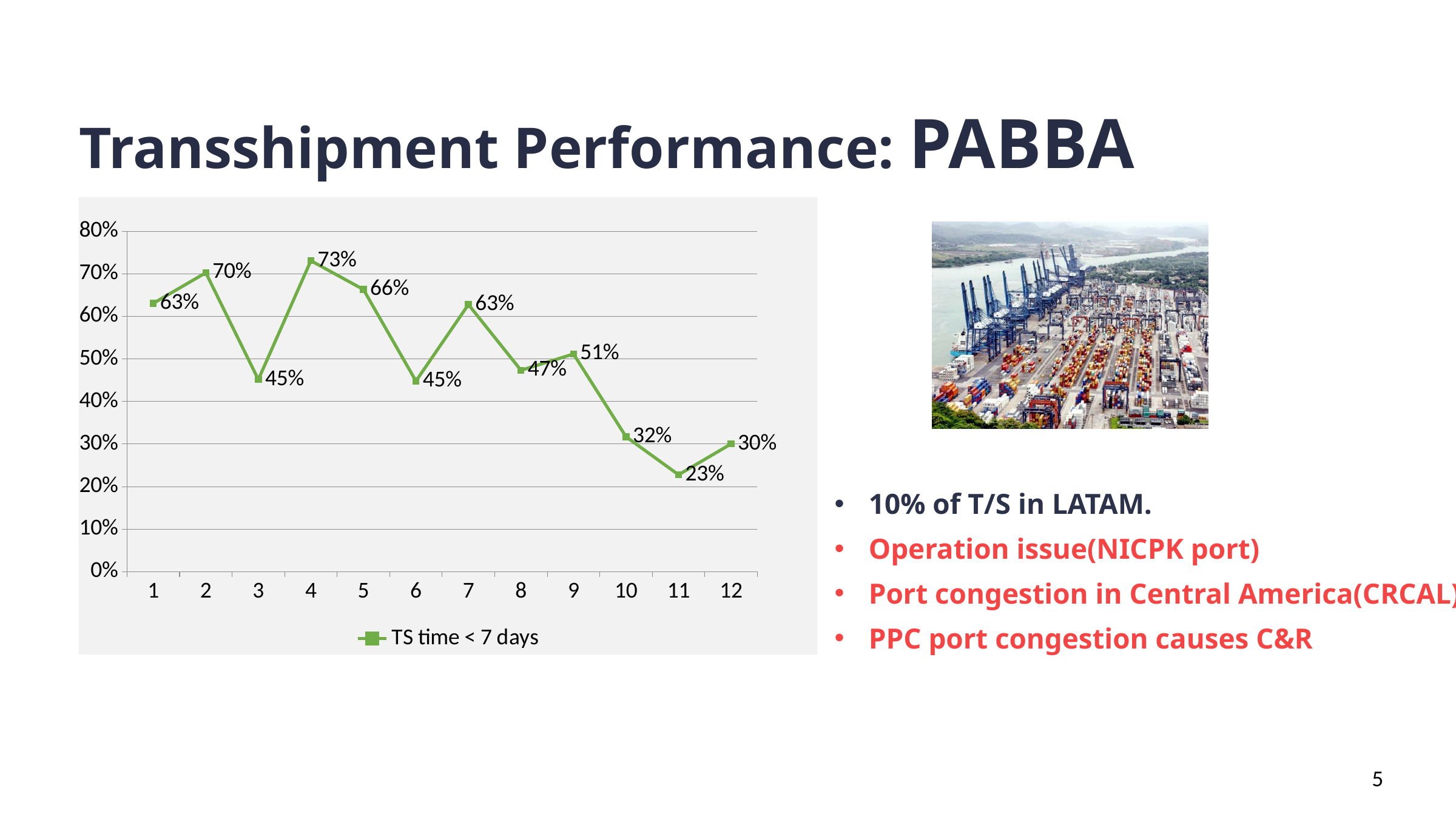
How many data points are plotted on the line? 12 What is the value of TS time < 7 days at point 4? 73% What is the difference between the values at point 2 and point 3? 25% What is the value of TS time < 7 days at point 9? 51% At which x-axis point is TS time < 7 days highest? 4 What is the difference between the values at point 4 and point 11? 50% Which is larger, the value at point 8 or the value at point 10? point 8 What is the name of the series shown in the legend? TS time < 7 days How many series does the legend list? 1 What is the value of TS time < 7 days at point 11? 23% At which x-axis point is TS time < 7 days lowest? 11 What kind of chart is shown on the slide? line chart